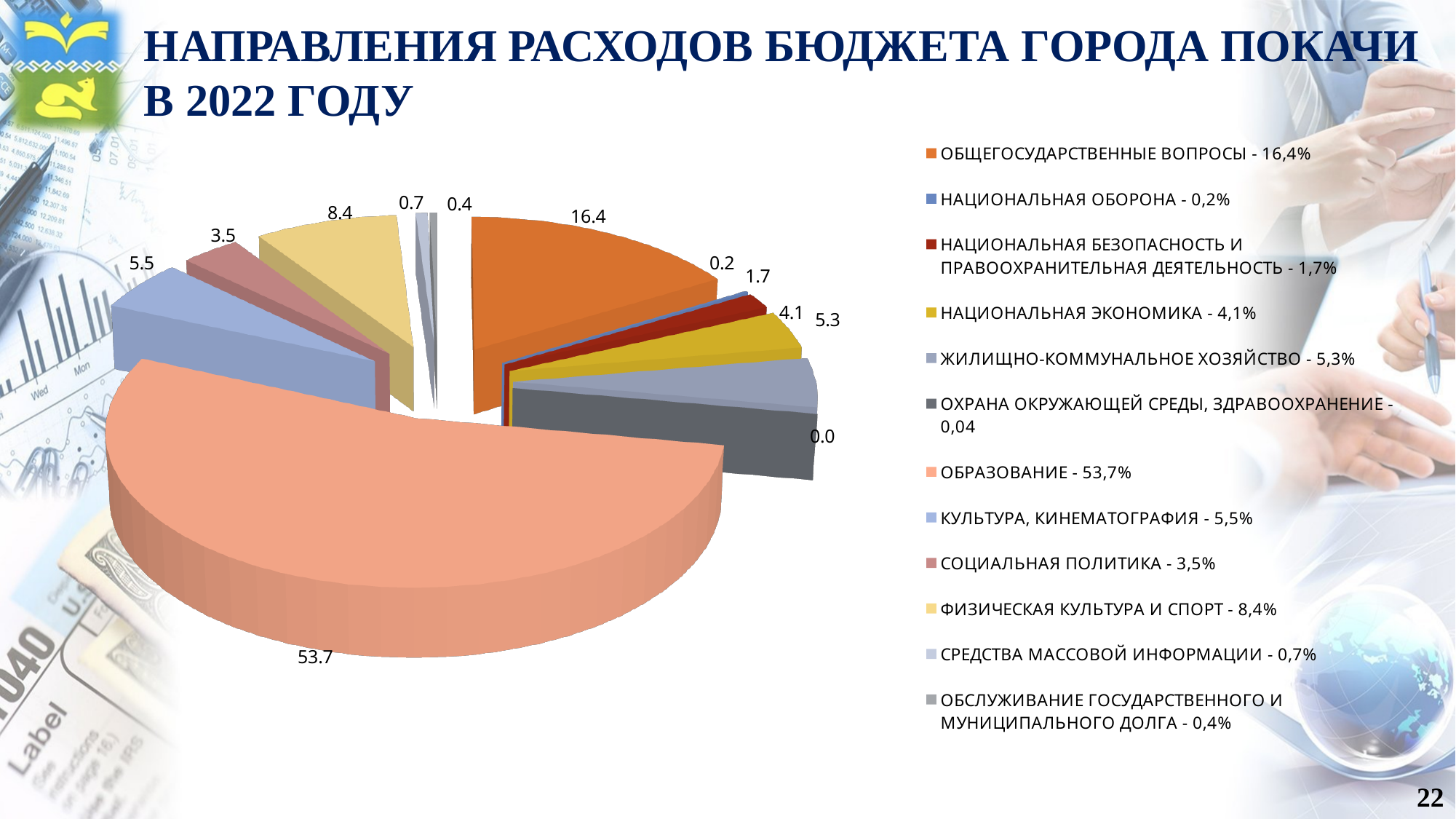
What is the data label for the ФИЗИЧЕСКАЯ КУЛЬТУРА И СПОРТ slice? 8.4 Which is larger: the slice for КУЛЬТУРА, КИНЕМАТОГРАФИЯ or the slice for СОЦИАЛЬНАЯ ПОЛИТИКА? КУЛЬТУРА, КИНЕМАТОГРАФИЯ Which category has the smallest share according to the data labels? ОХРАНА ОКРУЖАЮЩЕЙ СРЕДЫ, ЗДРАВООХРАНЕНИЕ What is the data label for the ОБЩЕГОСУДАРСТВЕННЫЕ ВОПРОСЫ slice? 16.4 What is the data label for the ЖИЛИЩНО-КОММУНАЛЬНОЕ ХОЗЯЙСТВО slice? 5.3 Which category has the largest slice of the pie? ОБРАЗОВАНИЕ What is the difference between the data labels for ОБРАЗОВАНИЕ and ОБЩЕГОСУДАРСТВЕННЫЕ ВОПРОСЫ? 37.3 What share of the budget does НАЦИОНАЛЬНАЯ ЭКОНОМИКА account for according to the legend? 4,1% How many categories does the legend list? 12 What colour is the ОБРАЗОВАНИЕ slice? light orange (salmon) What kind of chart is shown on the slide? pie chart What is the data label for the ОБРАЗОВАНИЕ slice? 53.7